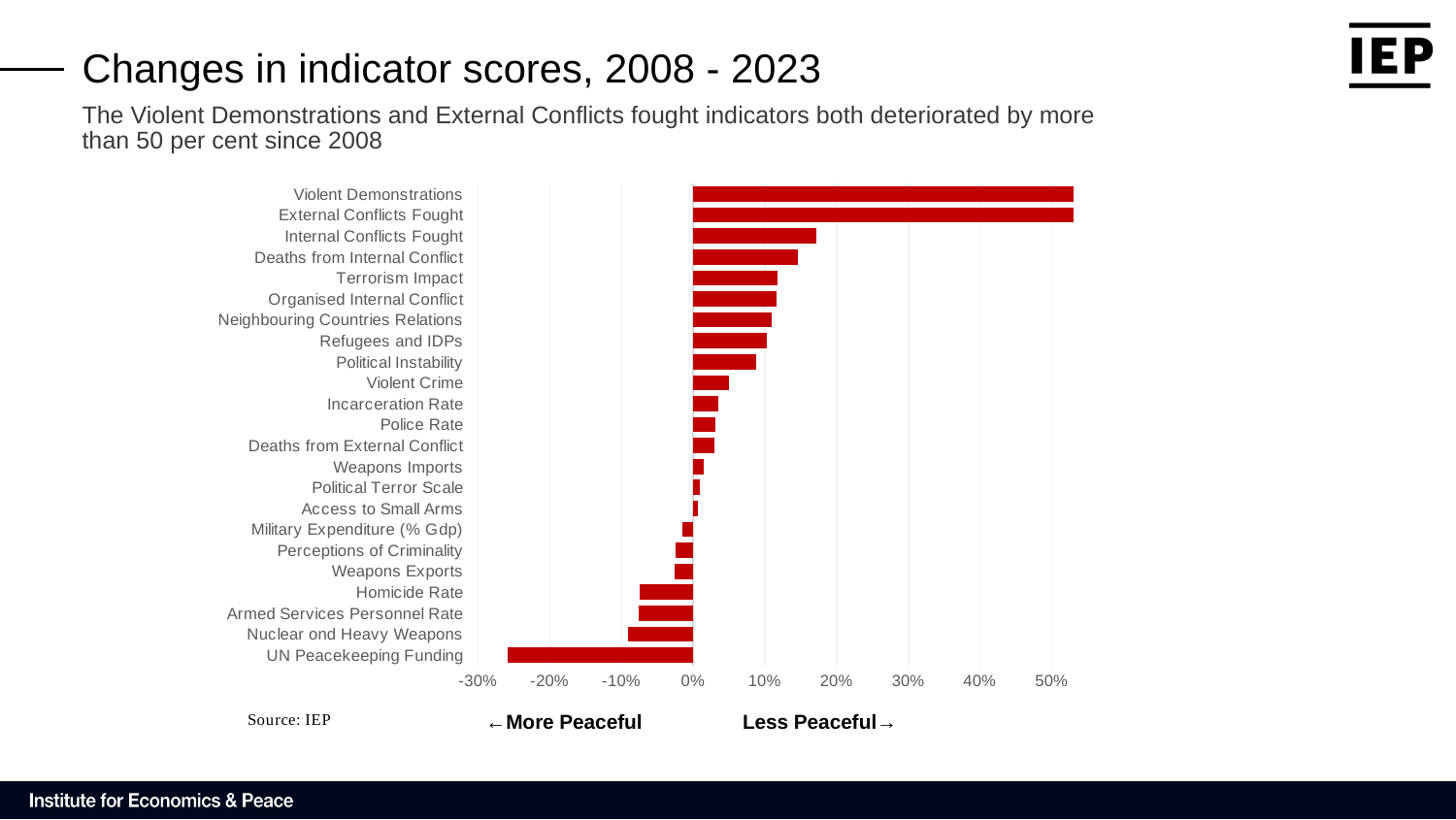
Is the value for Deaths from Internal Conflict greater or less than 10%? greater Is the value for Homicide Rate greater or less than -10%? greater What kind of chart is shown on the slide? Bar chart How many indicators are plotted in the chart? 23 Which has the larger change in score, Internal Conflicts Fought or Terrorism Impact? Internal Conflicts Fought Is the value for Violent Demonstrations greater or less than 50%? greater Which has the larger change in score, Political Instability or Violent Crime? Political Instability Which indicator has the lowest (most negative) change in score? UN Peacekeeping Funding What is the title of the chart? Changes in indicator scores, 2008 - 2023 What source is cited for the chart? IEP